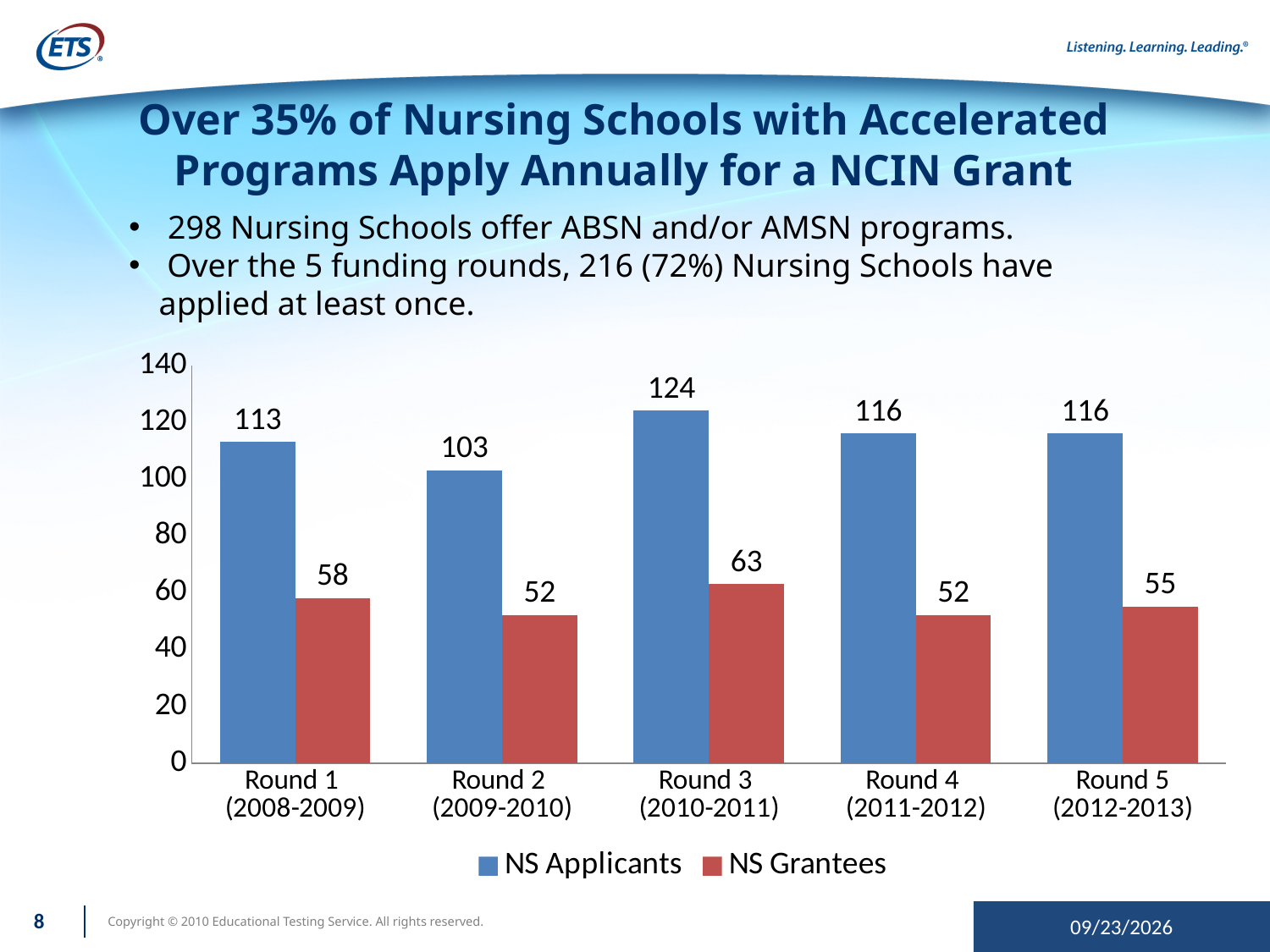
How many funding rounds are shown on the x axis? 5 Which is larger: NS Grantees in Round 5 (2012-2013) or NS Grantees in Round 4 (2011-2012)? Round 5 (2012-2013) Which round has the lowest number of NS Applicants? Round 2 (2009-2010) Which round has the highest number of NS Grantees? Round 3 (2010-2011) What is the number of NS Grantees in Round 1 (2008-2009)? 58 What kind of chart is shown on the slide? Bar chart What is the number of NS Applicants in Round 2 (2009-2010)? 103 What is the difference between NS Applicants and NS Grantees in Round 3 (2010-2011)? 61 Which round has the highest number of NS Applicants? Round 3 (2010-2011) What is the difference in NS Grantees between Round 1 (2008-2009) and Round 2 (2009-2010)? 6 What is the number of NS Applicants in Round 3 (2010-2011)? 124 How many series does the legend list? 2